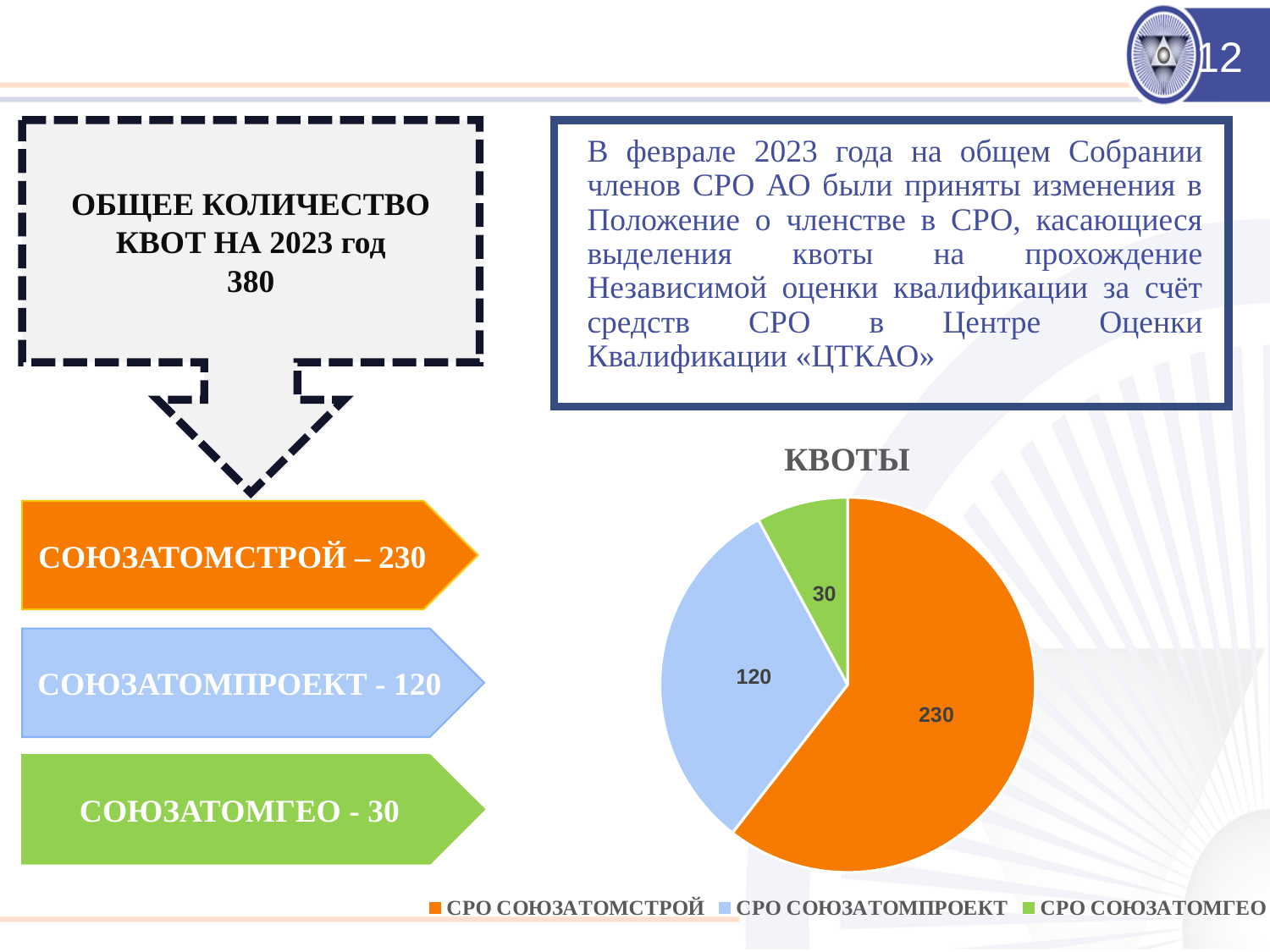
What colour is the slice for СРО СОЮЗАТОМГЕО in the КВОТЫ pie chart? green In the КВОТЫ pie chart, what is the value for СРО СОЮЗАТОМГЕО? 30 What is the total of all slices in the КВОТЫ pie chart? 380 In the КВОТЫ pie chart, what is the difference between the values for СРО СОЮЗАТОМПРОЕКТ and СРО СОЮЗАТОМГЕО? 90 What type of chart is shown under the title КВОТЫ? pie chart In the КВОТЫ pie chart, what is the difference between the values for СРО СОЮЗАТОМСТРОЙ and СРО СОЮЗАТОМПРОЕКТ? 110 How many slices does the КВОТЫ pie chart have? 3 In the КВОТЫ pie chart, which is larger: the value for СРО СОЮЗАТОМПРОЕКТ or СРО СОЮЗАТОМГЕО? СРО СОЮЗАТОМПРОЕКТ In the КВОТЫ pie chart, what is the value for СРО СОЮЗАТОМСТРОЙ? 230 In the КВОТЫ pie chart, what is the value for СРО СОЮЗАТОМПРОЕКТ? 120 Which category has the smallest slice in the КВОТЫ pie chart? СРО СОЮЗАТОМГЕО Which category has the largest slice in the КВОТЫ pie chart? СРО СОЮЗАТОМСТРОЙ